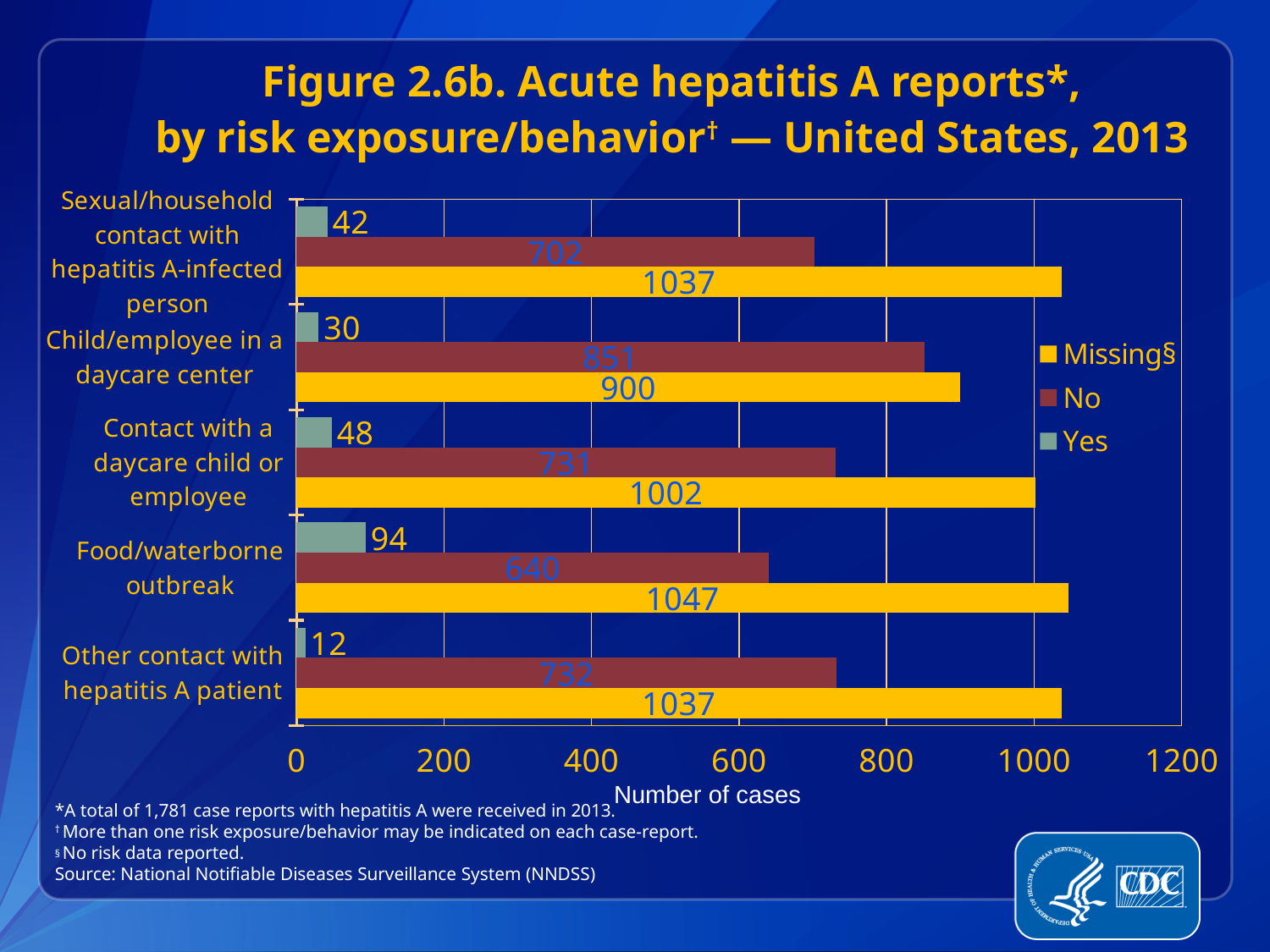
Which category has the highest "Yes" value? Food/waterborne outbreak What kind of chart is shown on the slide? Bar chart How many series does the legend list? 3 What is the difference between the "No" values for Child/employee in a daycare center and Food/waterborne outbreak? 211 Which is larger: the "No" value for Other contact with hepatitis A patient or the "No" value for Sexual/household contact with hepatitis A-infected person? Other contact with hepatitis A patient Which category has the lowest "Missing" value? Child/employee in a daycare center What is the number of cases for "No" in the Child/employee in a daycare center category? 851 What is the label of the x axis? Number of cases What is the number of cases for "Missing" in the Contact with a daycare child or employee category? 1002 What is the number of cases for "Yes" in the Food/waterborne outbreak category? 94 Which category has the lowest "Yes" value? Other contact with hepatitis A patient How many risk exposure/behavior categories are shown on the chart? 5